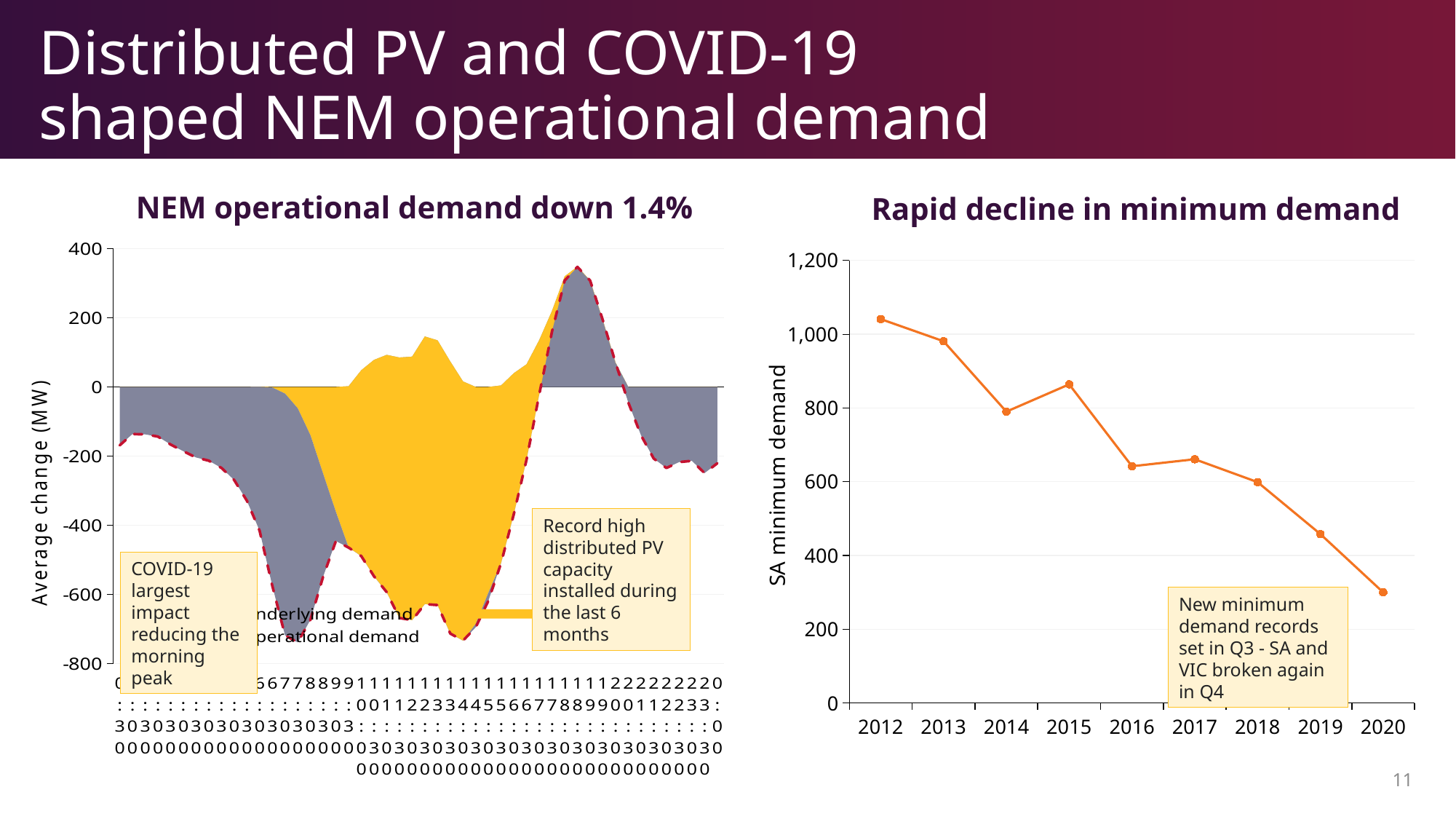
In the 'Rapid decline in minimum demand' chart, which year has the lowest SA minimum demand? 2020 In the 'Rapid decline in minimum demand' chart, which year has the highest SA minimum demand? 2012 In the 'Rapid decline in minimum demand' chart, is the value for 2012 greater or less than 1,000? greater In the 'Rapid decline in minimum demand' chart, which year has the higher SA minimum demand, 2014 or 2015? 2015 What is the y-axis label of the 'Rapid decline in minimum demand' chart? SA minimum demand In the 'NEM operational demand down 1.4%' chart, is the highest point of the dashed line greater or less than 200? greater In the 'Rapid decline in minimum demand' chart, is the value for 2019 greater or less than 600? less What kind of chart is the 'Rapid decline in minimum demand' chart? line chart What is the y-axis label of the 'NEM operational demand down 1.4%' chart? Average change (MW) In the 'Rapid decline in minimum demand' chart, do the values generally rise or fall from 2012 to 2020? fall In the 'Rapid decline in minimum demand' chart, how many years are plotted on the x axis? 9